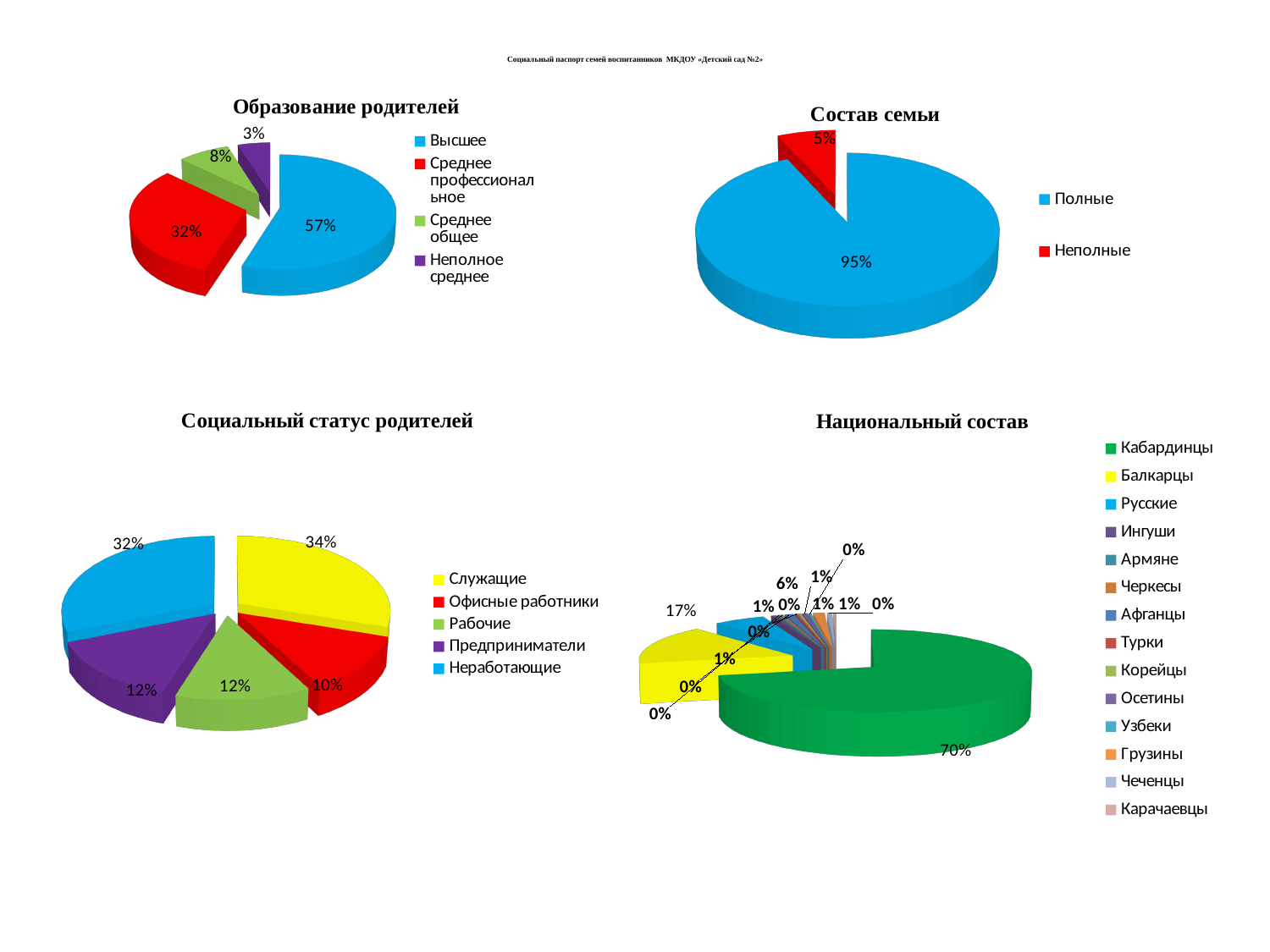
In the 'Образование родителей' chart, which category has the smallest share? Неполное среднее In the 'Состав семьи' chart, what percentage is shown for 'Неполные'? 5% In the 'Национальный состав' chart, what percentage is shown for 'Кабардинцы'? 70% In the 'Социальный статус родителей' chart, how many categories does the legend list? 5 In the 'Образование родителей' chart, what is the difference between the shares of 'Высшее' and 'Среднее профессиональное'? 25% In the 'Социальный статус родителей' chart, which category has the largest share? Служащие What type of chart is 'Состав семьи'? Pie chart In the 'Социальный статус родителей' chart, what percentage is shown for 'Служащие'? 34% In the 'Образование родителей' chart, what percentage is shown for 'Высшее'? 57% In the 'Социальный статус родителей' chart, which is larger: 'Неработающие' or 'Офисные работники'? Неработающие In the 'Состав семьи' chart, how many categories are shown? 2 In the 'Национальный состав' chart, how many entries does the legend list? 14